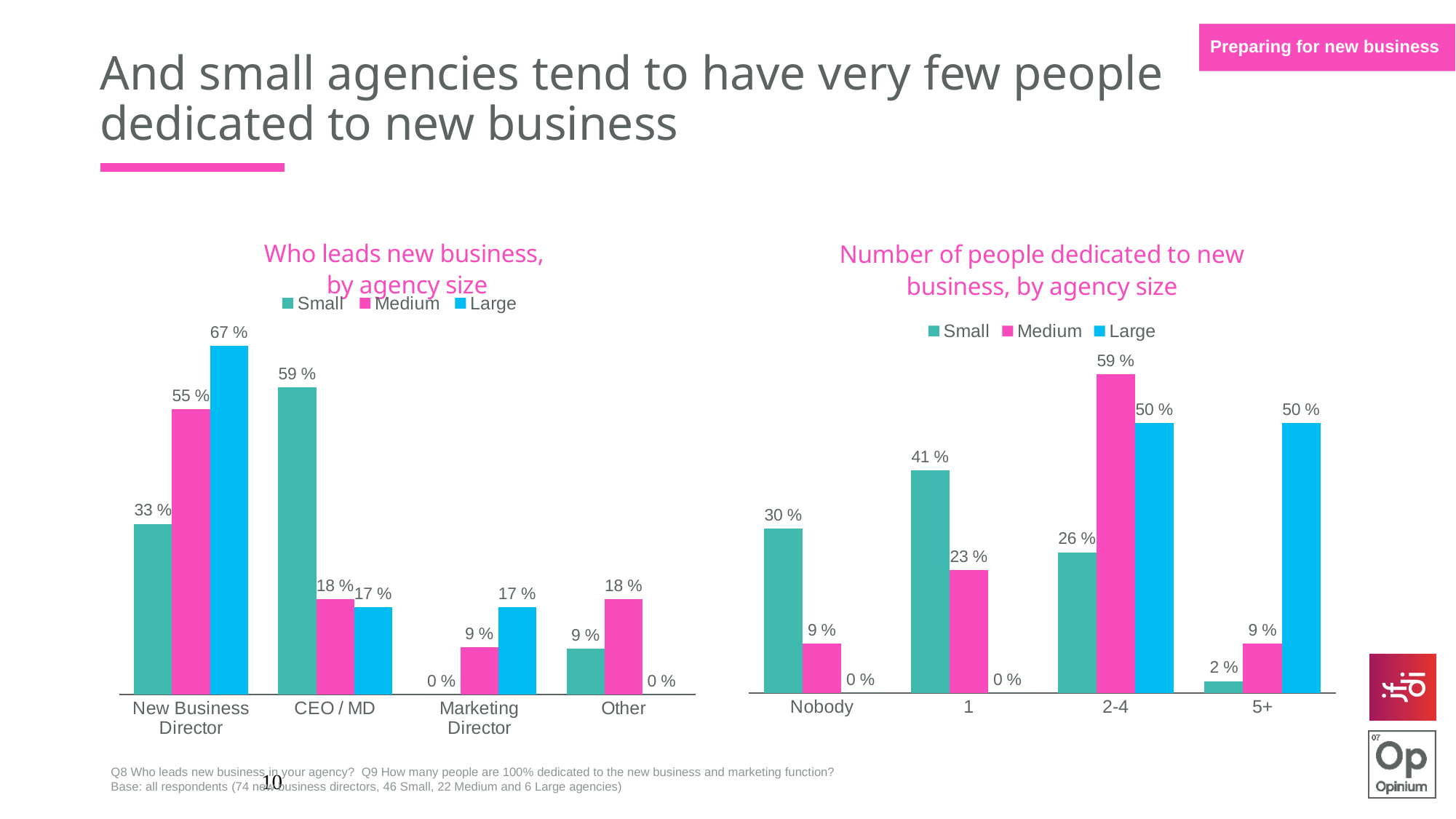
In the 'Who leads new business, by agency size' chart, what is the value for Small agencies in the CEO / MD category? 59 % In the 'Who leads new business, by agency size' chart, what is the difference between the Large and Small values for New Business Director? 34 % In the 'Number of people dedicated to new business, by agency size' chart, what is the value for Small agencies in the Nobody category? 30 % In the 'Number of people dedicated to new business, by agency size' chart, what is the difference between the Small and Medium values for the 1 category? 18 % In the 'Who leads new business, by agency size' chart, how many categories are shown on the x axis? 4 How many series does the legend list in the 'Number of people dedicated to new business, by agency size' chart? 3 In the 'Who leads new business, by agency size' chart, which category has the highest value for Small agencies? CEO / MD In the 'Number of people dedicated to new business, by agency size' chart, what is the value for Medium agencies in the 2-4 category? 59 % In the 'Number of people dedicated to new business, by agency size' chart, which is larger for the 1 category: Small or Medium? Small What kind of chart is the 'Who leads new business, by agency size' chart? Bar chart In the 'Who leads new business, by agency size' chart, what is the value for Large agencies in the New Business Director category? 67 % In the 'Number of people dedicated to new business, by agency size' chart, which category has the lowest value for Small agencies? 5+